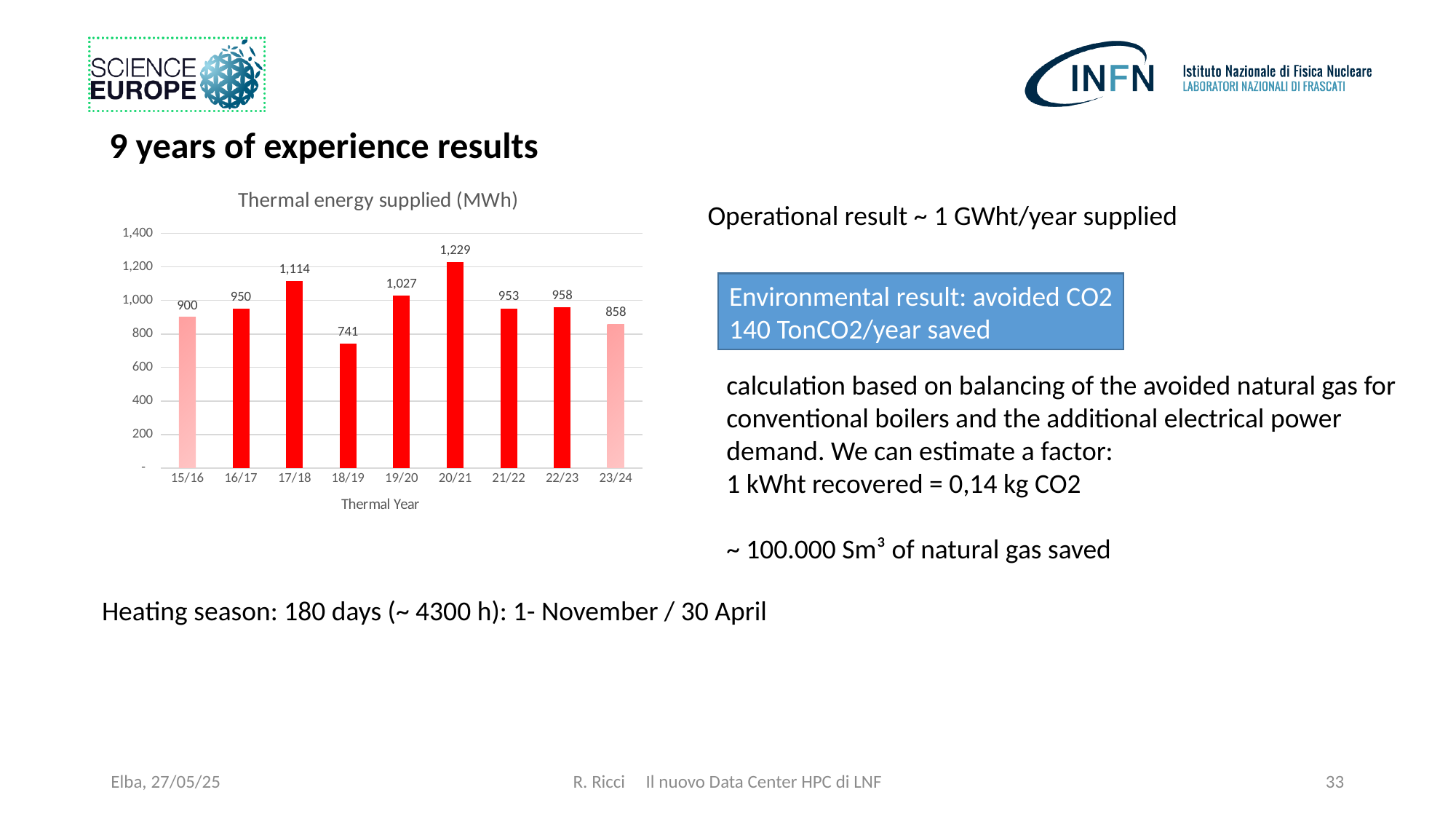
What is the label of the x axis of the chart? Thermal Year What is the title of the chart? Thermal energy supplied (MWh) Is the value for 21/22 greater or less than 1,000? less Which thermal year has the lowest thermal energy supplied? 18/19 What is the thermal energy supplied in thermal year 17/18? 1,114 How many thermal years are shown in the chart? 9 What kind of chart is shown on the slide? bar chart What is the difference in thermal energy supplied between 20/21 and 18/19? 488 Which thermal year has a higher value, 16/17 or 22/23? 22/23 What is the thermal energy supplied in thermal year 19/20? 1,027 Which thermal year has the highest thermal energy supplied? 20/21 What is the thermal energy supplied in thermal year 23/24? 858